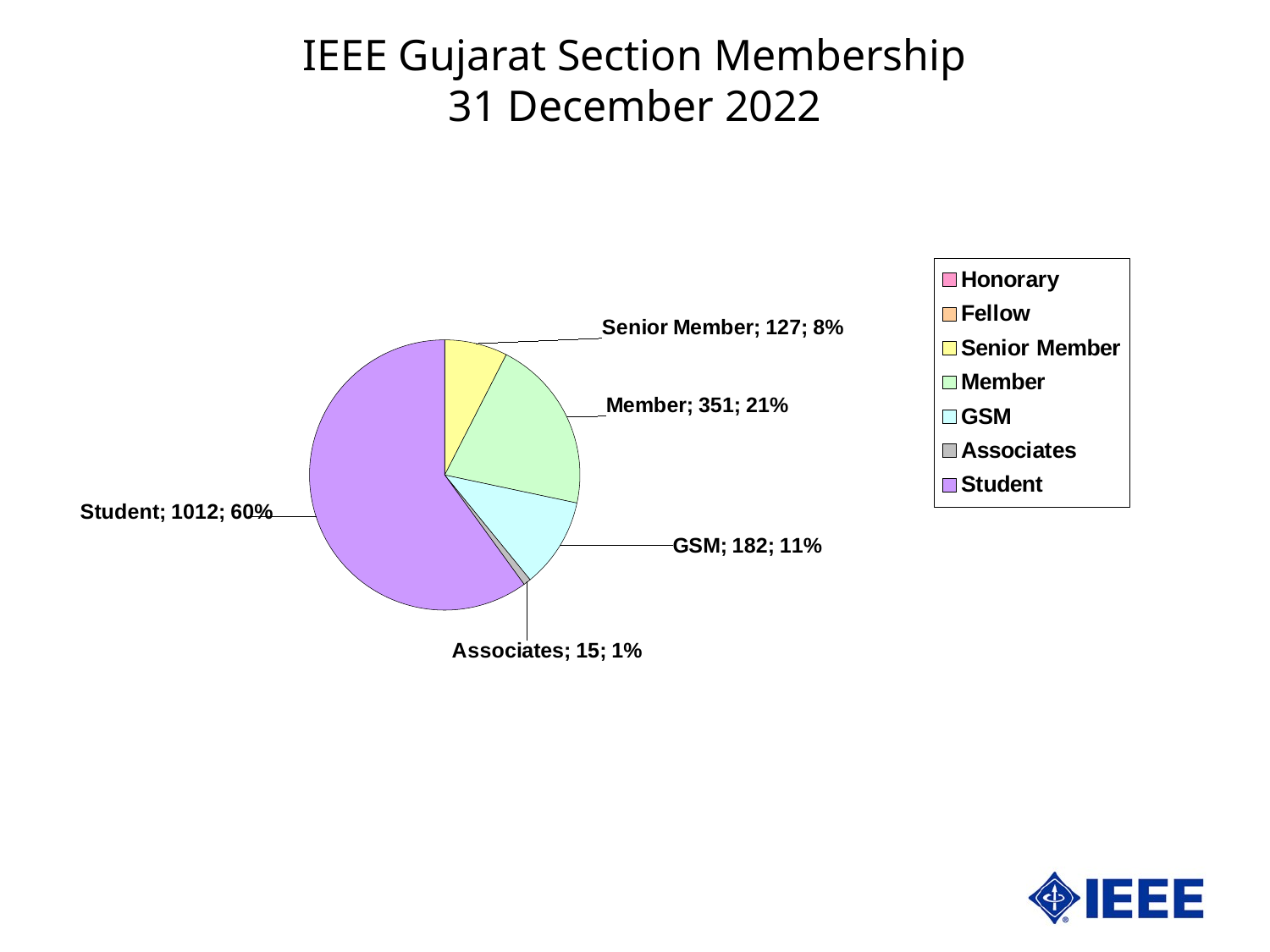
What is the title of the chart? IEEE Gujarat Section Membership 31 December 2022 Which is larger, the Senior Member value or the GSM value? GSM What share of the pie does the Member slice represent? 21% What kind of chart is shown on the slide? pie chart How many members does the Student slice represent? 1012 What is the value shown for Associates? 15 What is the value shown for GSM? 182 How many entries does the legend list? 7 What is the difference between the Member value and the GSM value? 169 What percentage is shown for Senior Member? 8% Which category has the largest slice of the pie? Student Which labelled slice has the smallest value? Associates